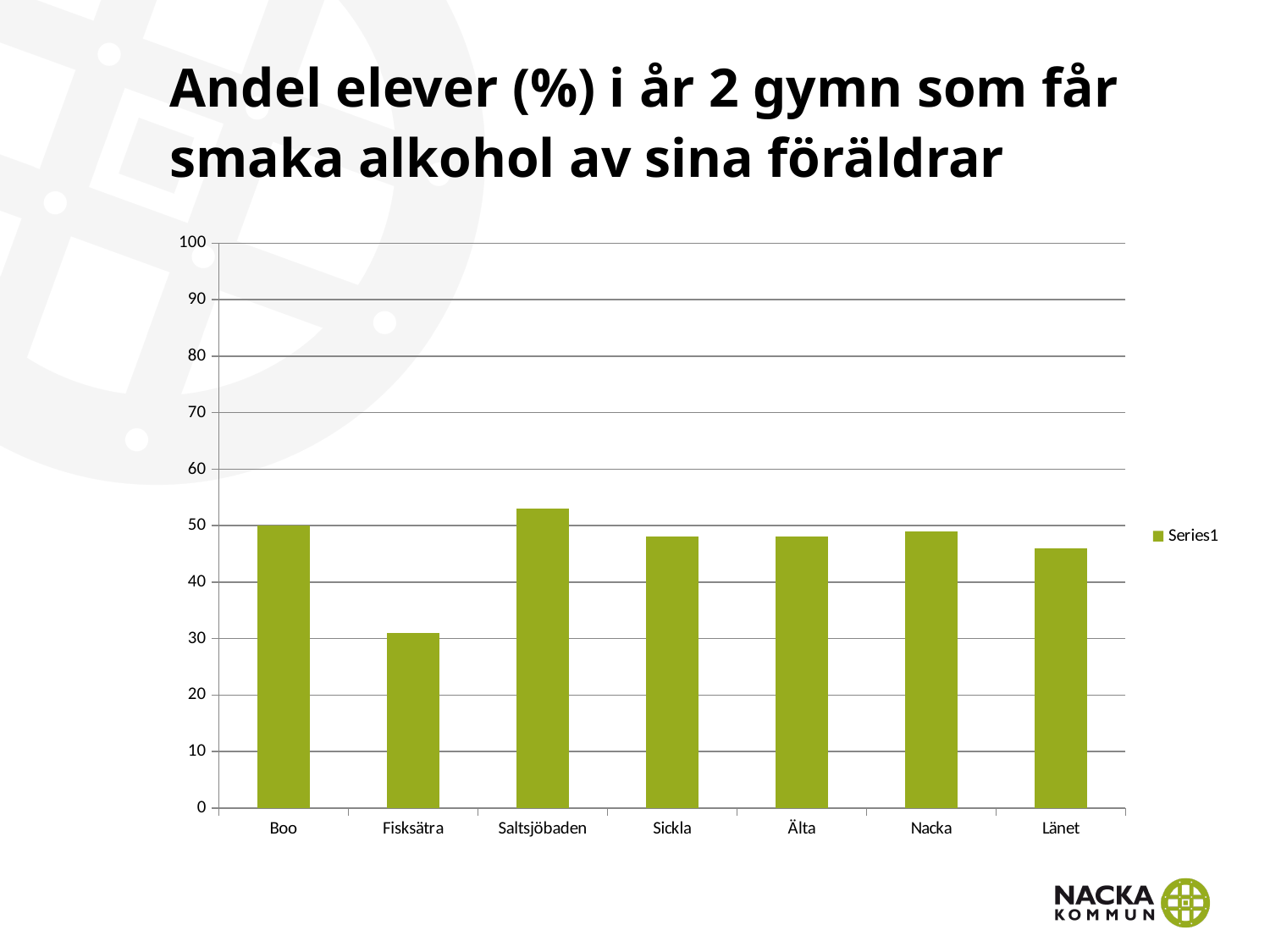
Is the value for Länet greater or less than 50? less What is the name of the series shown in the legend? Series1 Is the value for Saltsjöbaden greater or less than 50? greater How many series does the legend list? 1 Which category has the highest value in the chart? Saltsjöbaden How many categories are shown on the x axis of the chart? 7 Which is larger, the value for Boo or the value for Fisksätra? Boo What kind of chart is shown on the slide? bar chart What is the value for Boo? 50 Is the value for Fisksätra greater or less than 40? less Which is larger, the value for Saltsjöbaden or the value for Länet? Saltsjöbaden Which category has the lowest value in the chart? Fisksätra